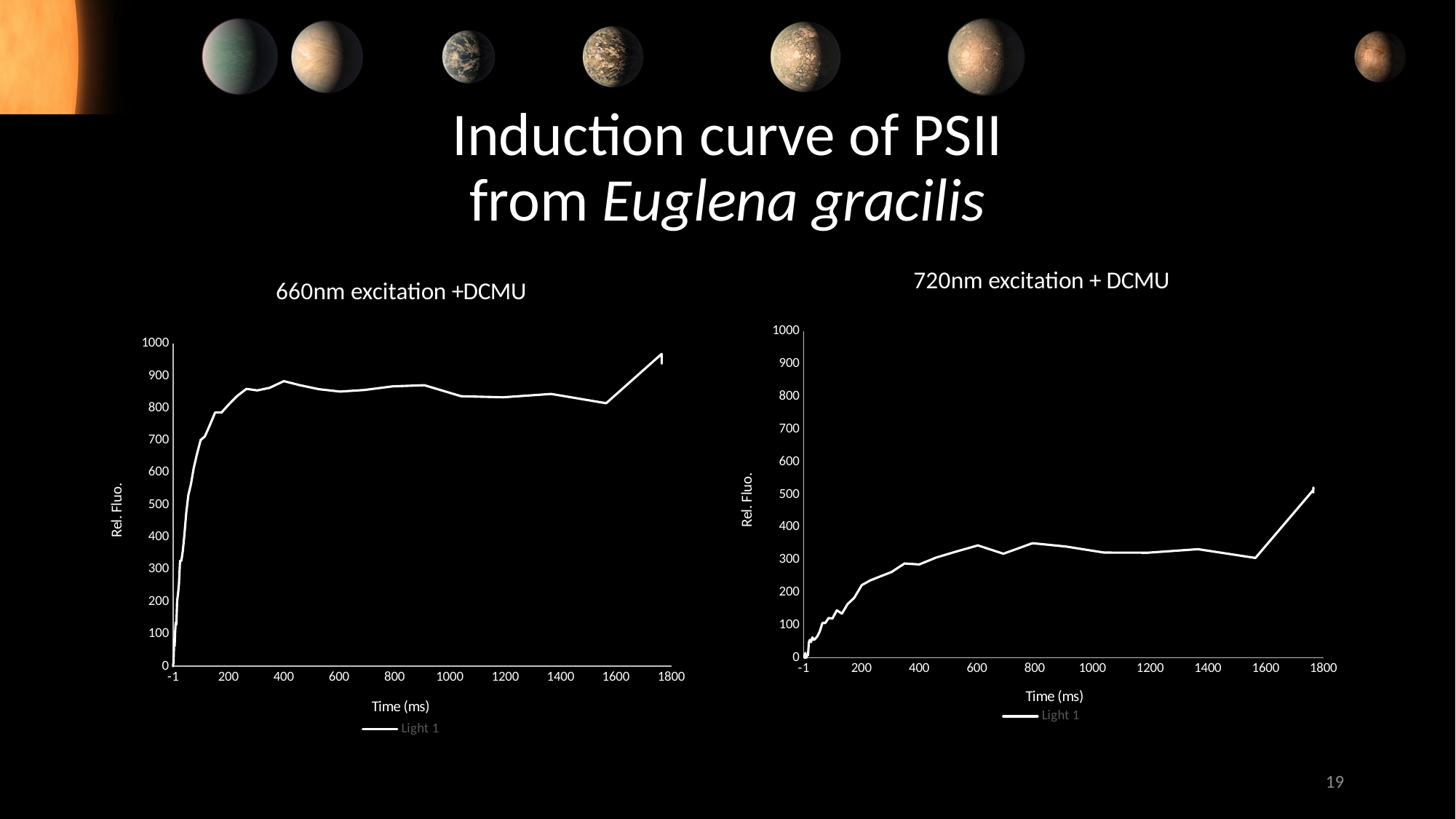
In the '720nm excitation + DCMU' chart, is the value at 1800 ms greater or less than 400? greater In the '660nm excitation +DCMU' chart, is the value at 1000 ms greater or less than 800? greater In the '660nm excitation +DCMU' chart, is the value at 1800 ms greater or less than 900? greater What is the y-axis label of the '660nm excitation +DCMU' chart? Rel. Fluo. How many series does the legend of the '660nm excitation +DCMU' chart list? 1 In the '720nm excitation + DCMU' chart, does the value rise or fall between 0 and 600 ms? rise What kind of chart is the '660nm excitation +DCMU' chart? line chart What is the legend entry shown on the '720nm excitation + DCMU' chart? Light 1 What kind of chart is the '720nm excitation + DCMU' chart? line chart At 1000 ms, which chart shows the larger Rel. Fluo. value, '660nm excitation +DCMU' or '720nm excitation + DCMU'? 660nm excitation +DCMU